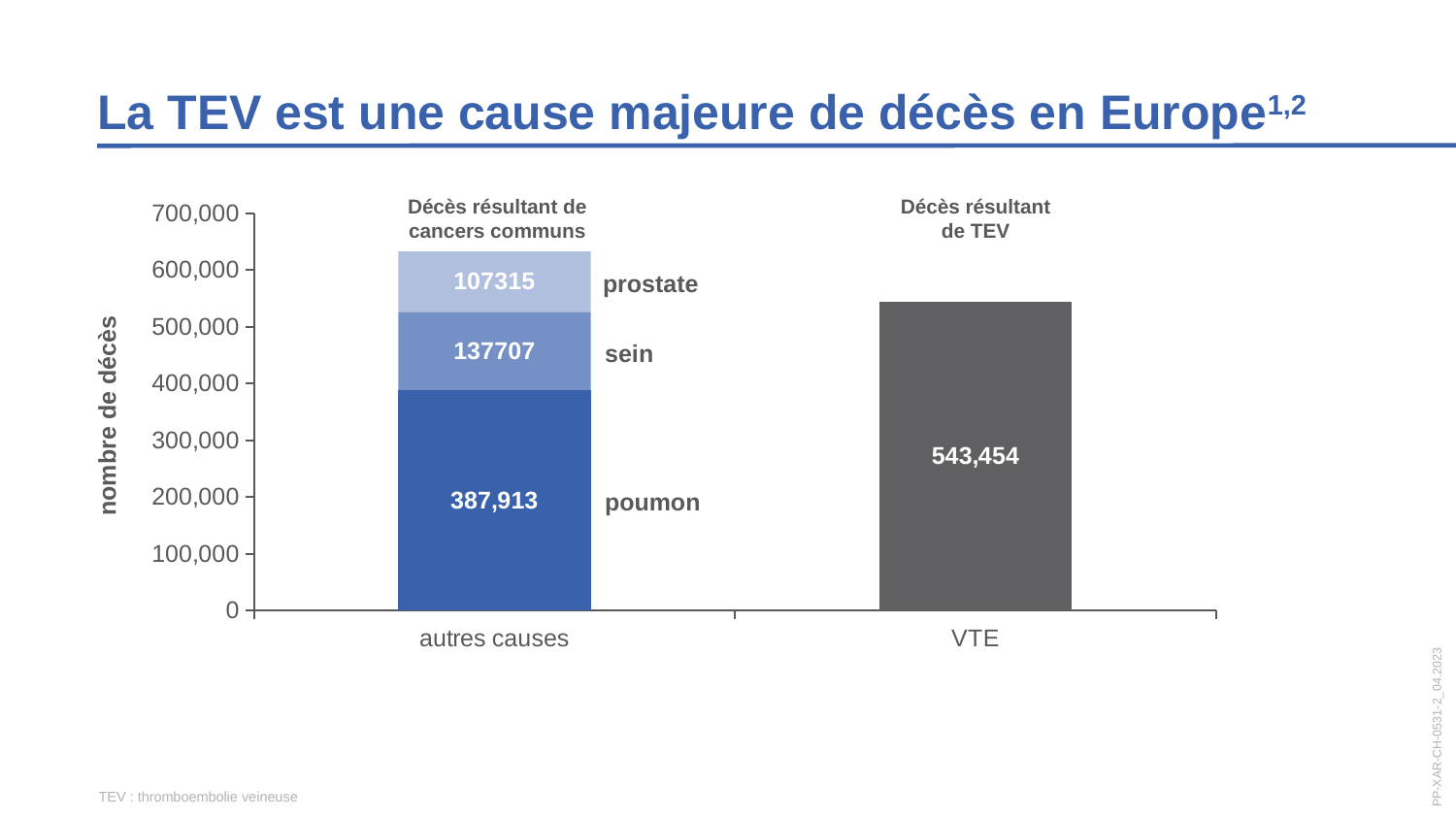
What value is printed for the prostate segment? 107315 Which is larger: the VTE value or the poumon value? VTE What is the title of the y axis? nombre de décès Which cancer segment in the 'autres causes' bar has the smallest value? prostate What is the difference between the VTE value and the poumon value? 155,541 What value is printed for the sein (breast cancer) segment? 137707 What is the number of deaths shown for the VTE bar? 543,454 What kind of chart is shown on the slide? bar chart How many categories are shown on the x axis? 2 What is the total of the stacked 'autres causes' bar (poumon + sein + prostate)? 632,935 Which cancer segment in the 'autres causes' bar has the largest value? poumon What is the number of deaths shown for poumon (lung cancer) in the stacked bar? 387,913